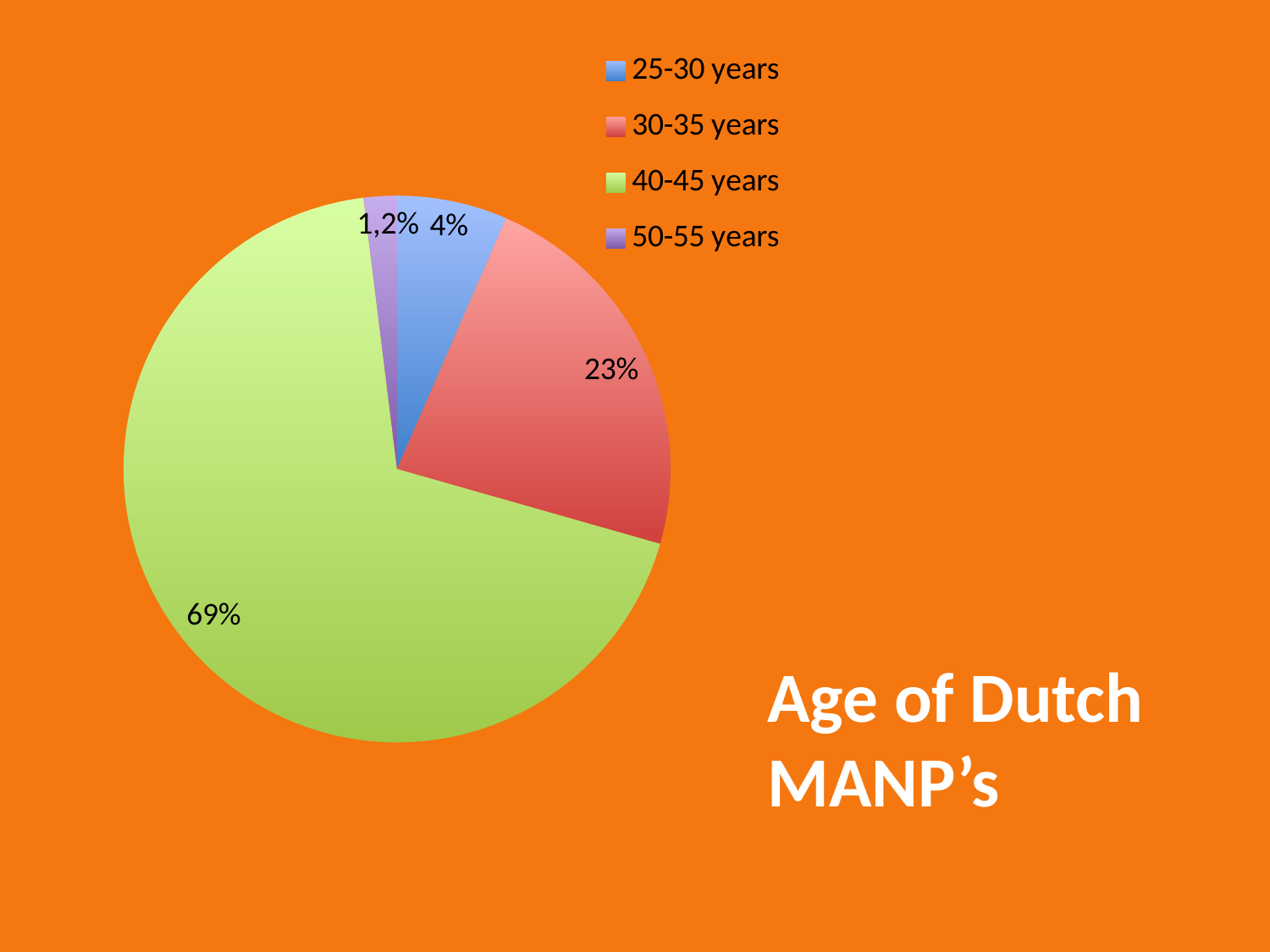
What is the difference in percentage points between the 40-45 years slice and the 30-35 years slice? 46 How many entries does the legend list? 4 Which age group has the smallest slice of the pie? 50-55 years What share of the pie does the 50-55 years slice represent? 1,2% Which slice is larger, 30-35 years or 25-30 years? 30-35 years What share of the pie does the 30-35 years slice represent? 23% Which age group has the largest slice of the pie? 40-45 years How many age groups are shown in the pie chart? 4 What colour is the 40-45 years slice? green What share of the pie does the 40-45 years slice represent? 69% What type of chart is shown on the slide? pie chart